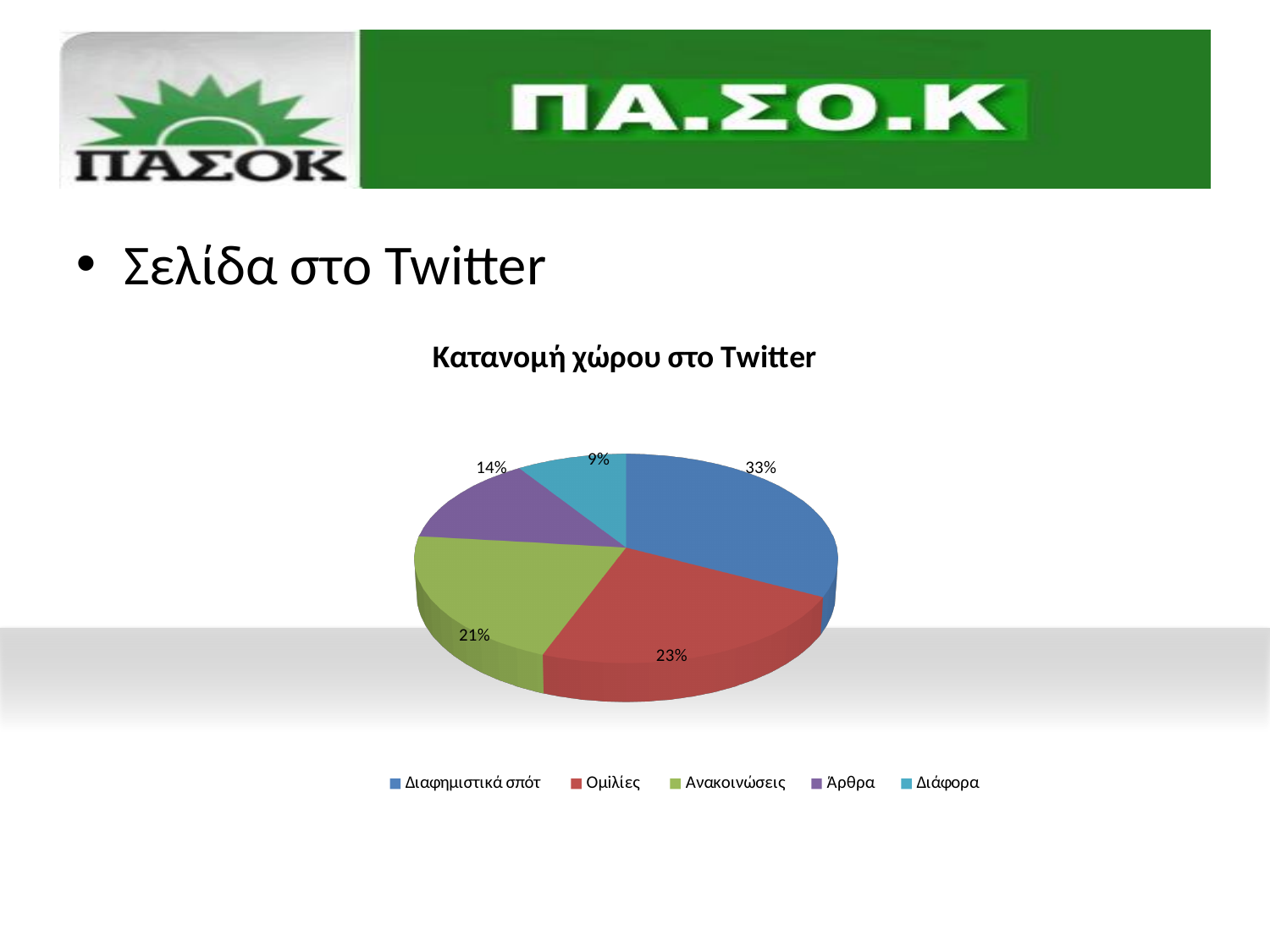
Which category has the largest share of the pie? Διαφημιστικά σπότ What type of chart is shown on the slide? Pie chart How many categories does the legend list? 5 Which category has the smallest share of the pie? Διάφορα Which has a larger share, Άρθρα or Διάφορα? Άρθρα What is the title of the chart? Κατανομή χώρου στο Twitter What percentage of the pie is Διάφορα? 9% What is the difference between the shares of Διαφημιστικά σπότ and Ομιλίες? 10% What percentage of the pie is Διαφημιστικά σπότ? 33% What percentage of the pie is Άρθρα? 14% What percentage of the pie is Ανακοινώσεις? 21% What percentage of the pie is Ομιλίες? 23%